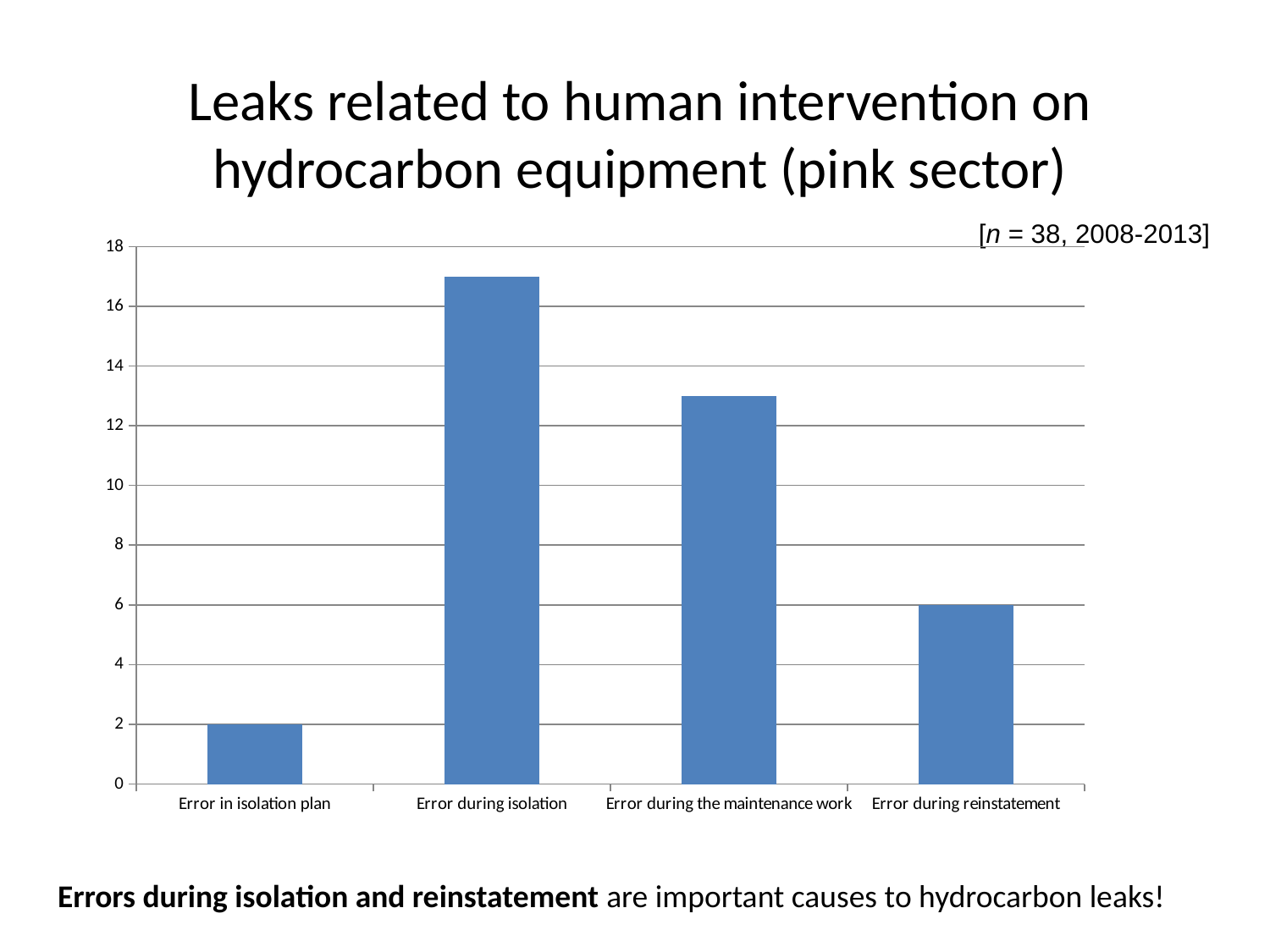
Is the value for Error during isolation greater or less than 16? greater How many categories are shown on the x axis of the chart? 4 What is the value for Error during reinstatement? 6 Which is larger, the value for Error during isolation or the value for Error during the maintenance work? Error during isolation What is the difference between the values for Error during reinstatement and Error in isolation plan? 4 Which category has the lowest value? Error in isolation plan What is the value for Error in isolation plan? 2 Is the value for Error during the maintenance work greater or less than 14? less Which category has the highest value? Error during isolation What type of chart is shown on the slide? bar chart What is the title of the chart on the slide? Leaks related to human intervention on hydrocarbon equipment (pink sector) Is the value for Error during the maintenance work greater or less than 12? greater